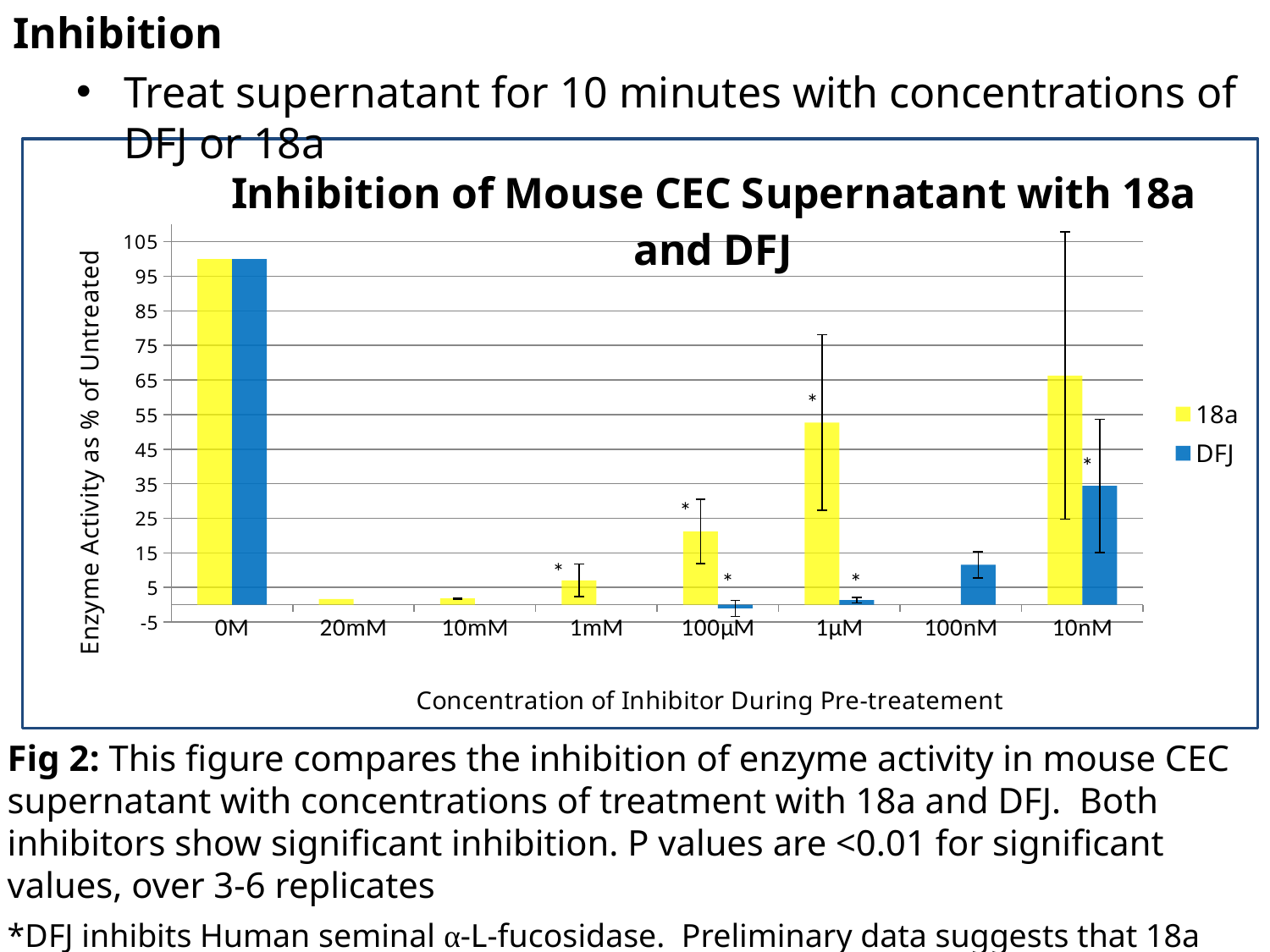
Is the value for DFJ at 100nM greater or less than 15? less What is the label of the y axis? Enzyme Activity as % of Untreated At 100nM, which series has the larger value, 18a or DFJ? DFJ At 1µM, which series has the larger value, 18a or DFJ? 18a Is the value for 18a at 1µM greater or less than 45? greater Which series is shown in yellow? 18a How many concentration categories are shown on the x axis? 8 At which concentration is the 18a bar highest? 0M What kind of chart is shown on the slide? bar chart Is the value for 18a at 100µM greater or less than 15? greater How many series does the legend list? 2